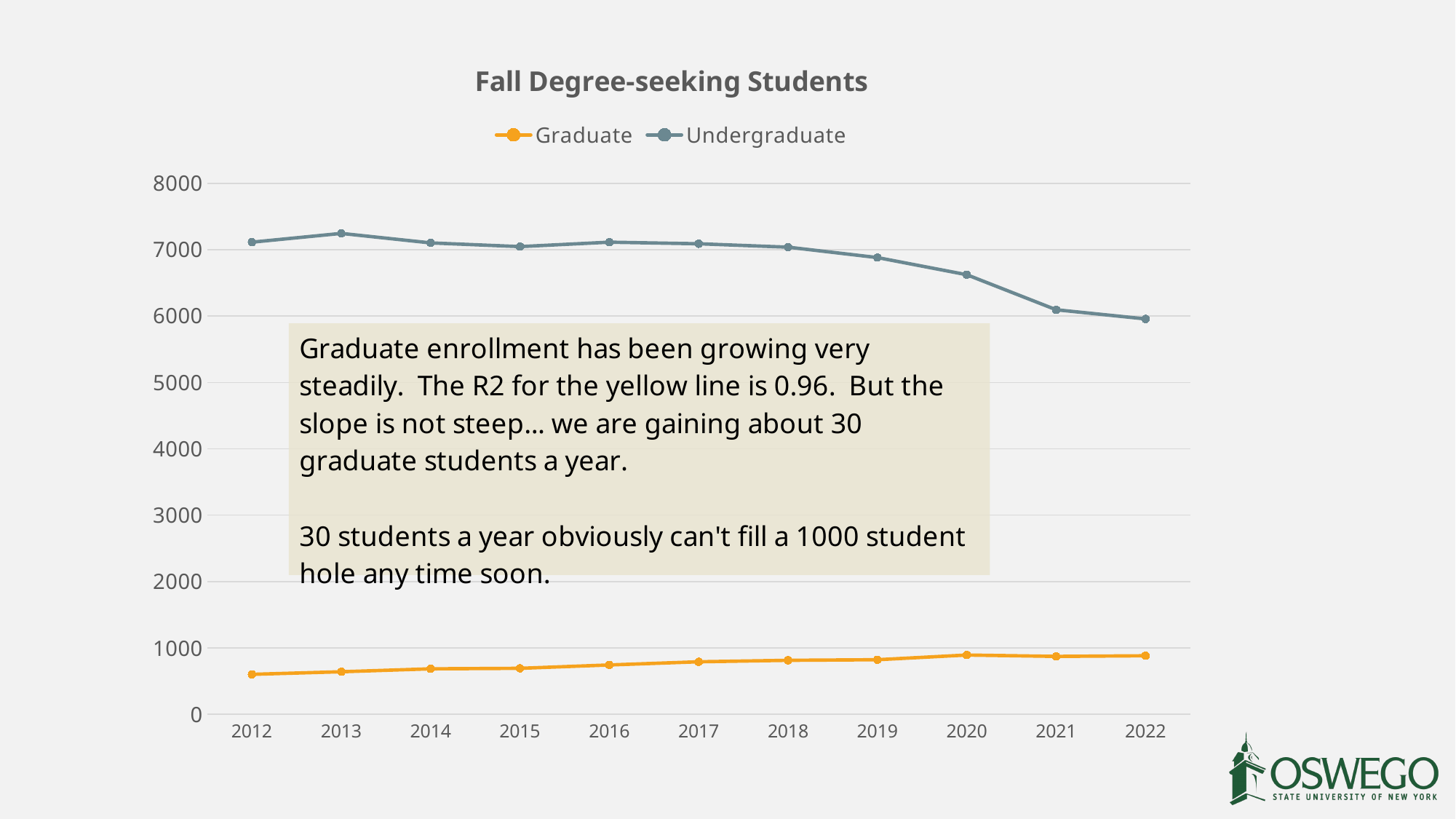
Is the Undergraduate value for 2021 greater or less than 6000? greater Does the Undergraduate line rise or fall overall from 2012 to 2022? Fall In which year is the Undergraduate value highest? 2013 Is the Undergraduate value for 2020 greater or less than 7000? less What kind of chart is shown on the slide? Line chart Is the Graduate value for 2020 greater or less than 1000? less In which year is the Graduate value lowest? 2012 Which series is drawn in yellow/orange? Graduate How many years are plotted along the x axis? 11 How many series does the legend list? 2 In which year is the Undergraduate value lowest? 2022 What is the title of the chart? Fall Degree-seeking Students